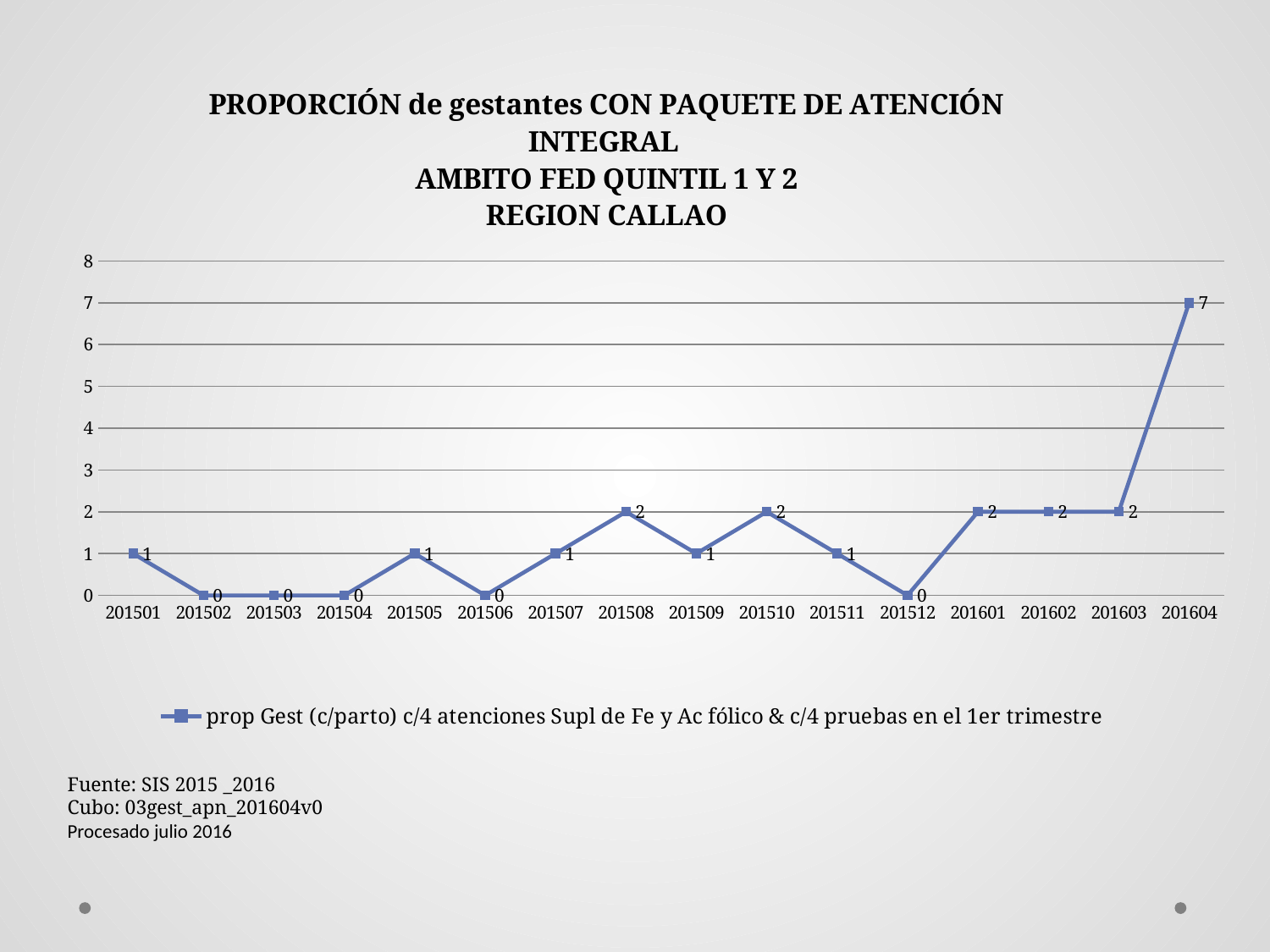
What is the value for 201512? 0 What type of chart is shown on the slide? line chart What is the value for 201501? 1 Which region is named in the chart title? REGION CALLAO What is the difference between the values for 201604 and 201603? 5 Which period has the highest value? 201604 What is the value for 201604? 7 Which is larger, the value for 201510 or the value for 201511? 201510 How many periods are plotted on the x axis? 16 How many series does the legend list? 1 Is the value for 201604 greater or less than 5? greater What is the value for 201508? 2